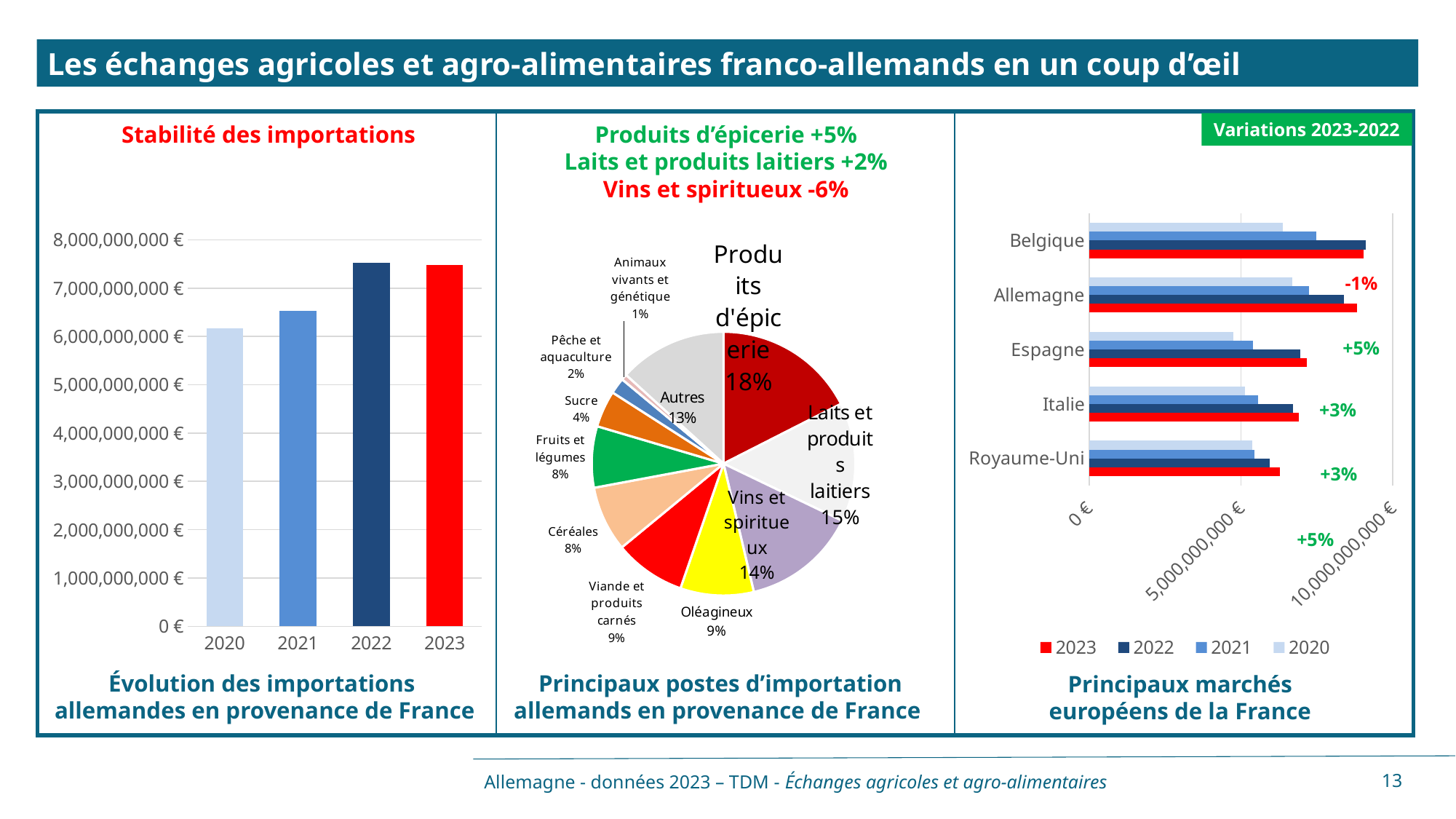
In the left chart 'Évolution des importations allemandes en provenance de France', which year has the lowest value? 2020 In the middle pie chart 'Principaux postes d'importation allemands en provenance de France', how many percentage points larger is Produits d'épicerie than Laits et produits laitiers? 3 In the left chart 'Évolution des importations allemandes en provenance de France', is the value for 2022 greater or less than 7,000,000,000 €? greater In the right chart 'Principaux marchés européens de la France', which country has the highest 2023 value? Belgique In the middle pie chart 'Principaux postes d'importation allemands en provenance de France', which category has the largest share? Produits d'épicerie In the middle pie chart 'Principaux postes d'importation allemands en provenance de France', which category has the smallest share? Animaux vivants et génétique In the middle pie chart 'Principaux postes d'importation allemands en provenance de France', what share does Vins et spiritueux have? 14% In the left chart 'Évolution des importations allemandes en provenance de France', is the value for 2021 greater or less than 7,000,000,000 €? less In the middle pie chart 'Principaux postes d'importation allemands en provenance de France', how many slices are there? 11 What kind of chart is the left chart, 'Évolution des importations allemandes en provenance de France'? bar chart In the right chart 'Principaux marchés européens de la France', how many series does the legend list? 4 In the left chart 'Évolution des importations allemandes en provenance de France', how many years are shown? 4